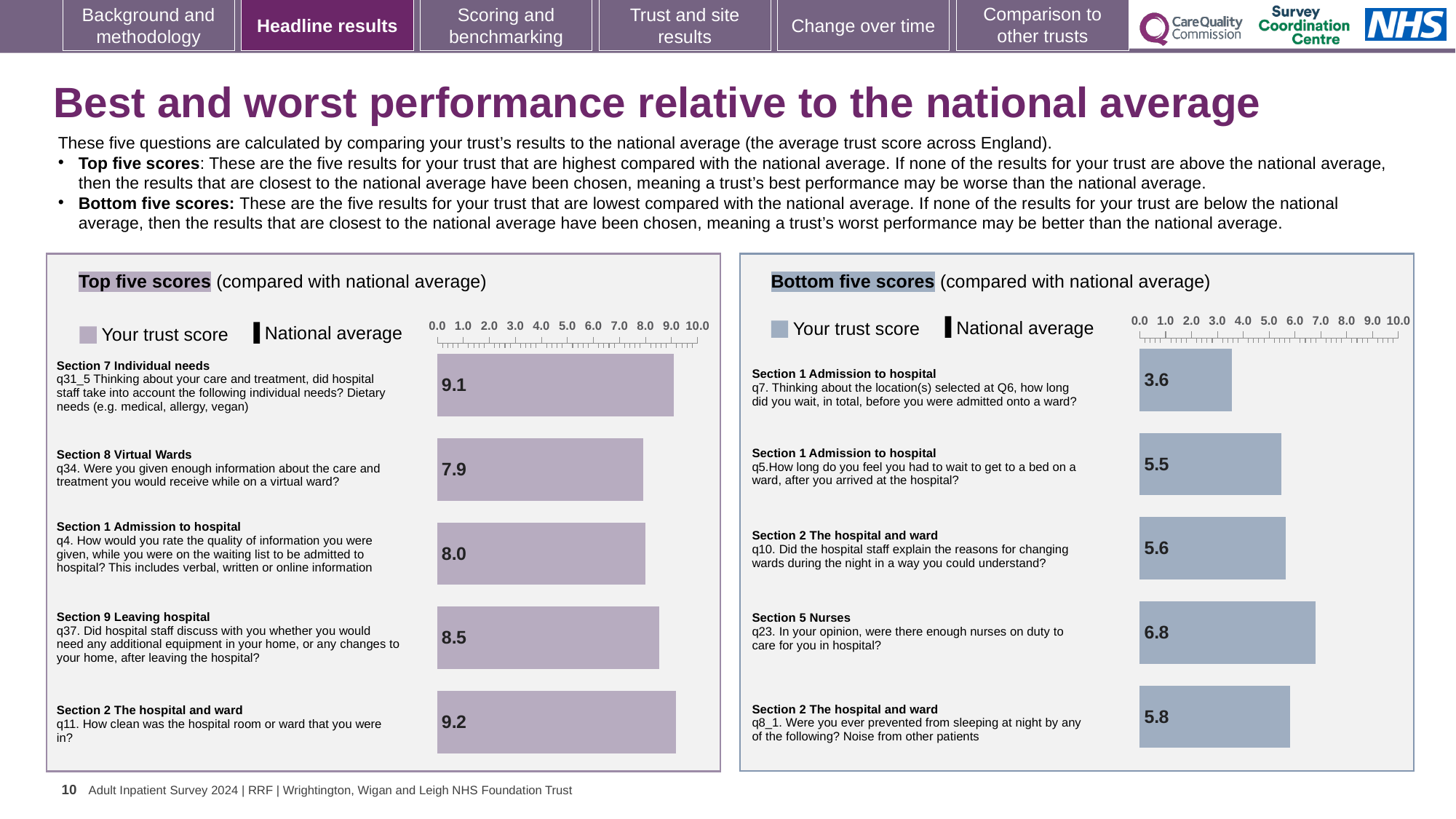
In the Top five scores chart, what is the trust score for q34 about information on care and treatment on a virtual ward? 7.9 In the Bottom five scores chart, what is the difference between the scores for q23 and q7? 3.2 In the Top five scores chart, what is the difference between the scores for q11 (9.2) and q34 (7.9)? 1.3 How many bars are plotted in the Bottom five scores chart? 5 In the Bottom five scores chart, which question has the lowest trust score? q7 (how long did you wait before you were admitted onto a ward) What kind of chart is used for the Top five scores? Bar chart In the Top five scores chart, which has the larger trust score: q37 about additional equipment after leaving hospital, or q4 about information while on the waiting list? q37 In the Bottom five scores chart, what is the trust score for q23 about whether there were enough nurses on duty? 6.8 In the Bottom five scores chart, which question has the highest trust score? q23 (were there enough nurses on duty) In the Top five scores chart, what is the trust score for q11 (How clean was the hospital room or ward that you were in?)? 9.2 In the Bottom five scores chart, what is the trust score for q7 about how long you waited before being admitted onto a ward? 3.6 In the Bottom five scores chart, is the trust score for q7 greater or less than 4.0? less